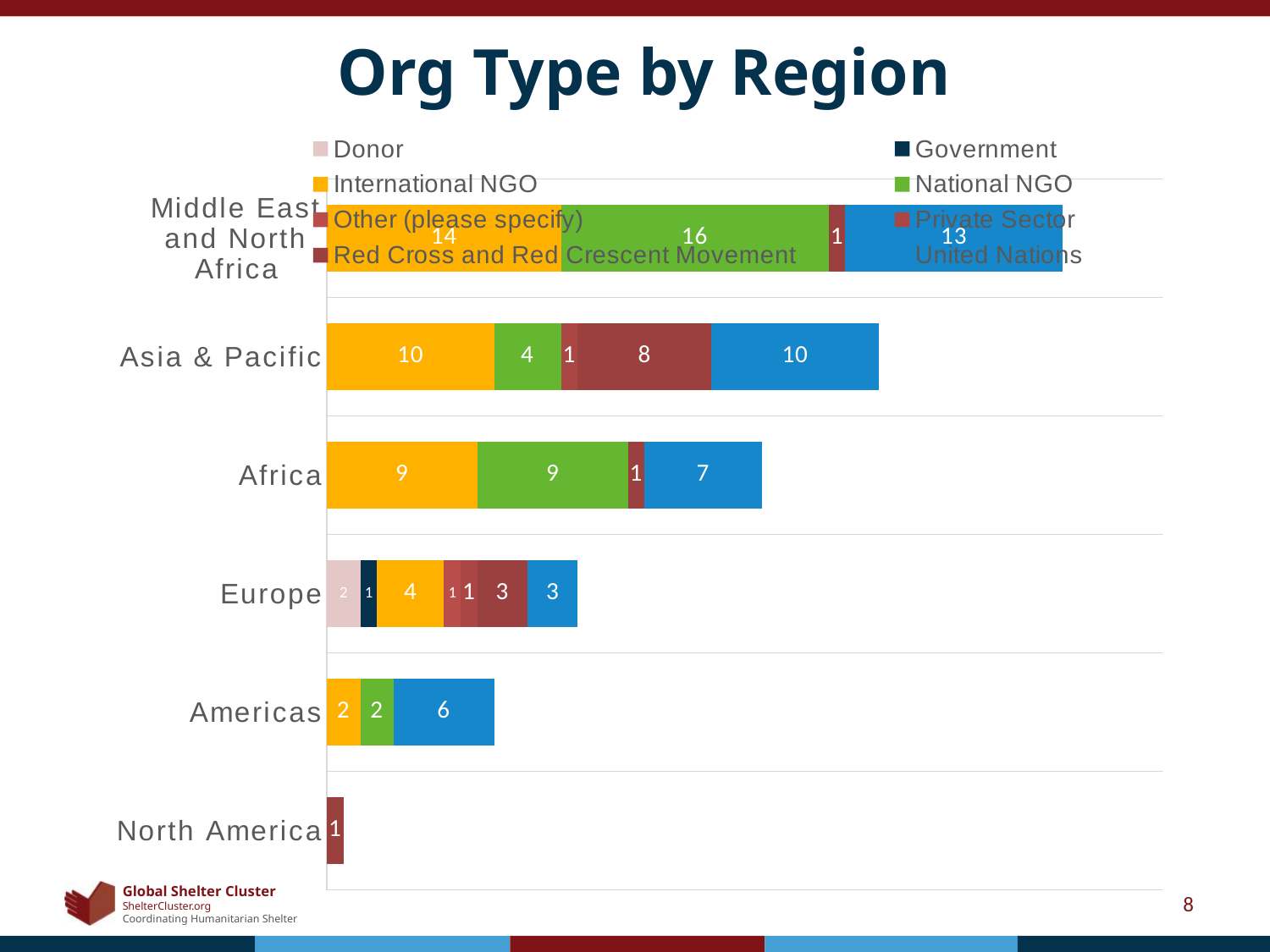
What is the total of the stacked bar for Africa? 26 How many series does the legend list? 8 What is the difference between the National NGO value for Middle East and North Africa and the National NGO value for Asia & Pacific? 12 What is the United Nations value for Americas? 6 What is the total of the stacked bar for Asia & Pacific? 33 Which region has the longest stacked bar overall? Middle East and North Africa What type of chart is shown on the slide? Stacked bar chart What is the International NGO value for Africa? 9 What is the National NGO value for Middle East and North Africa? 16 What is the Donor value for Europe? 2 What is the United Nations value for Asia & Pacific? 10 How many regions are shown on the chart? 6